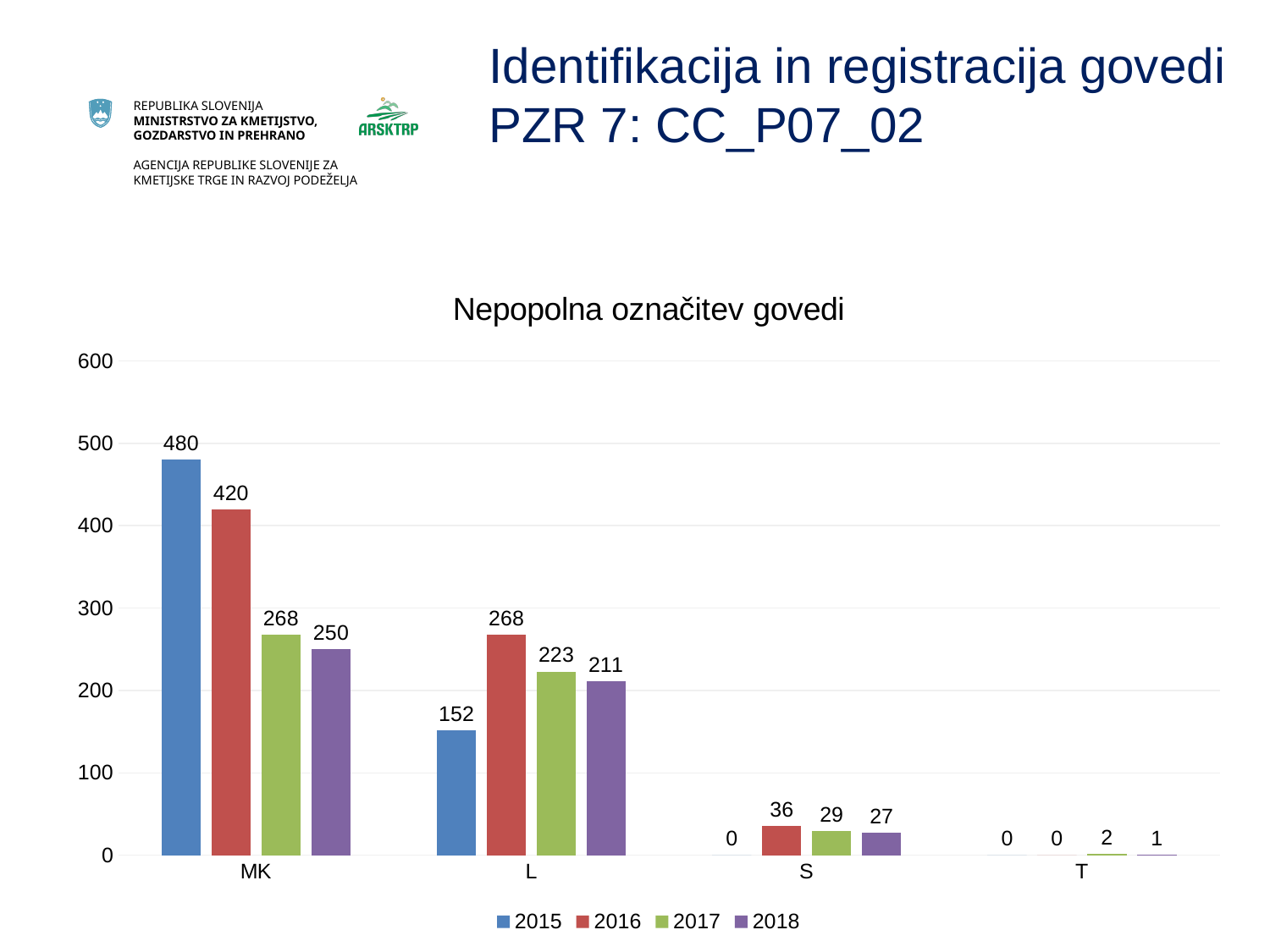
What is the difference between the 2015 and 2016 values in the MK category? 60 Which category has the lowest value for 2018? T Which category has the highest value for 2016? MK How many series does the legend list? 4 How many categories are shown on the x axis? 4 What is the title of the chart? Nepopolna označitev govedi What is the value for 2017 in the L category? 223 What is the value for 2018 in the T category? 1 What is the value for 2015 in the MK category? 480 What is the difference between the 2016 and 2015 values in the L category? 116 Which is larger in the L category: the 2017 value or the 2018 value? 2017 What is the value for 2016 in the S category? 36